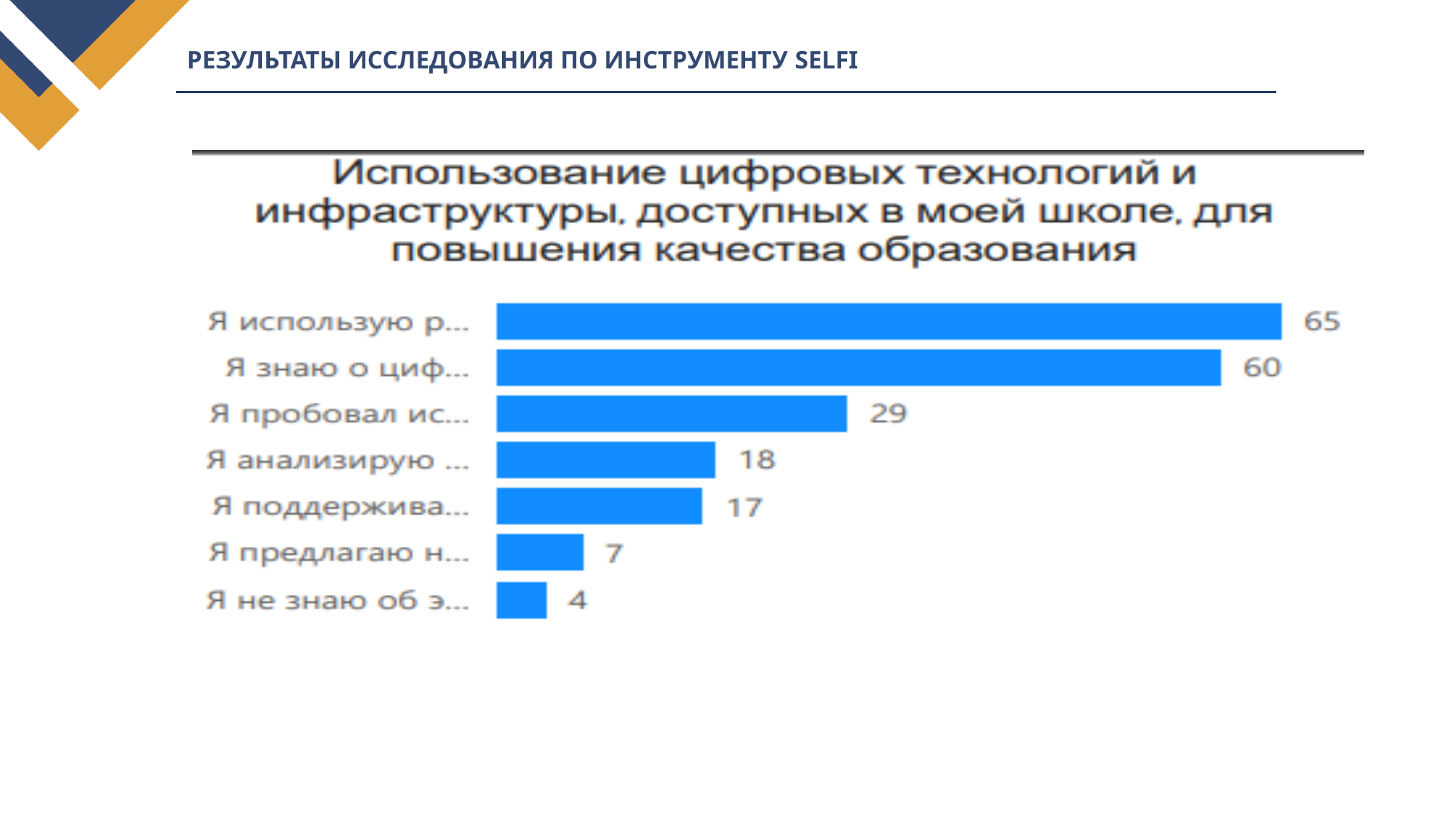
How many categories (bars) does the chart show? 7 What is the value for the category labelled "Я пробовал ис..."? 29 What is the difference between the values for "Я пробовал ис..." and "Я предлагаю н..."? 22 What is the difference between the values for "Я использую р..." and "Я знаю о циф..."? 5 What type of chart is shown on the slide? bar chart What is the value for the category labelled "Я знаю о циф..."? 60 What is the value for the category labelled "Я не знаю об э..."? 4 Which category has the highest value? Я использую р... What is the value for the category labelled "Я использую р..."? 65 What is the title of the chart? Использование цифровых технологий и инфраструктуры, доступных в моей школе, для повышения качества образования Which has a larger value: "Я анализирую ..." or "Я предлагаю н..."? Я анализирую ... Which category has the lowest value? Я не знаю об э...